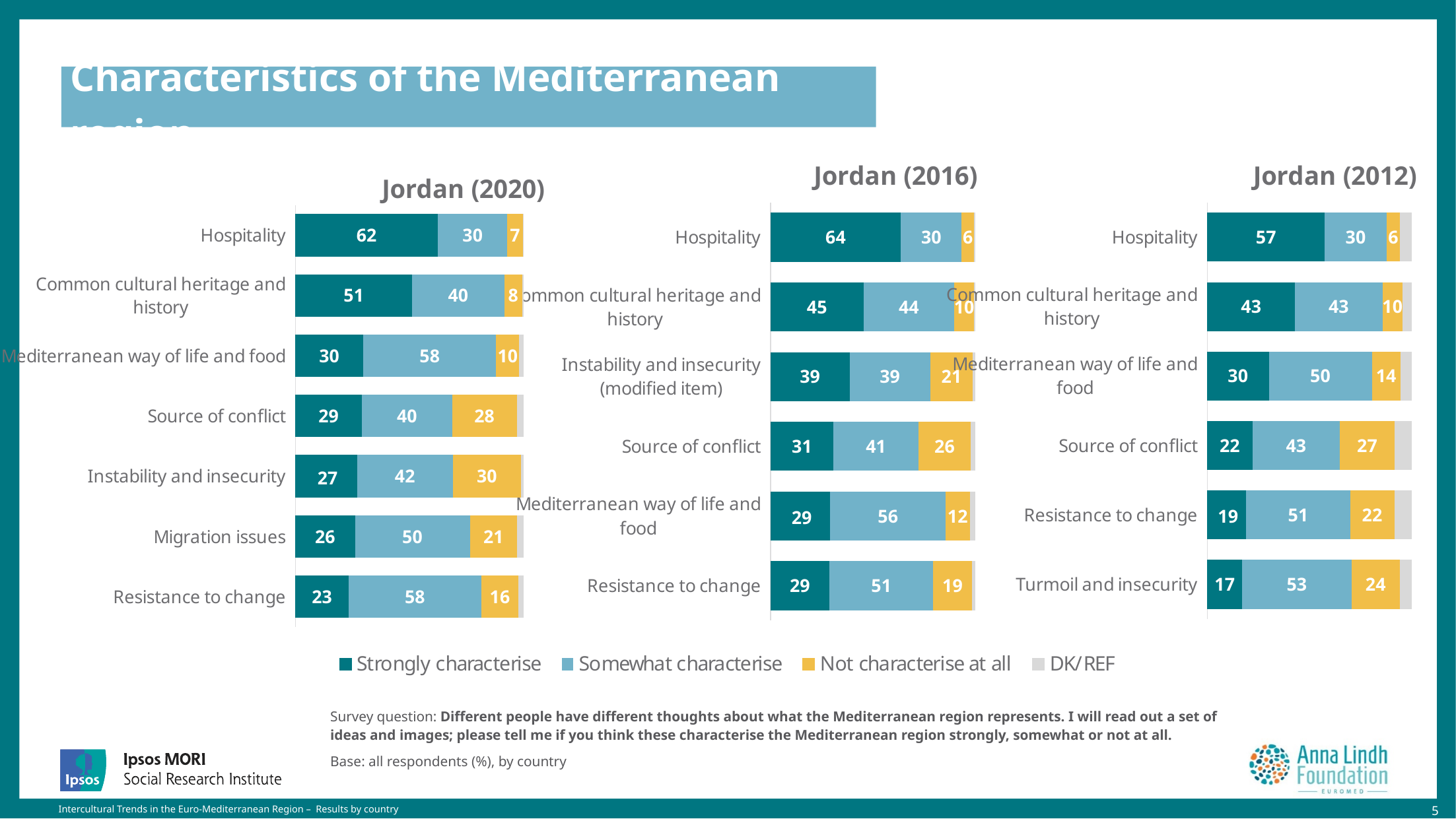
In the Jordan (2012) chart, what is the 'Somewhat characterise' value for Turmoil and insecurity? 53 In the Jordan (2020) chart, which category has the highest 'Strongly characterise' value? Hospitality How many series does the legend list? 4 In the Jordan (2020) chart, what is the difference between the 'Strongly characterise' values for Hospitality and Resistance to change? 39 How many categories are shown in the Jordan (2016) chart? 6 In the Jordan (2012) chart, what is the 'Not characterise at all' value for Mediterranean way of life and food? 14 In the Jordan (2016) chart, what is the 'Not characterise at all' value for Source of conflict? 26 In the Jordan (2012) chart, which category has the lowest 'Strongly characterise' value? Turmoil and insecurity What type of chart is used for Jordan (2020)? stacked bar chart In the Jordan (2016) chart, is the 'Strongly characterise' value for Hospitality larger or smaller than that for Common cultural heritage and history? larger Which legend entry is shown in yellow? Not characterise at all In the Jordan (2020) chart, what percentage say Hospitality strongly characterises the Mediterranean region? 62